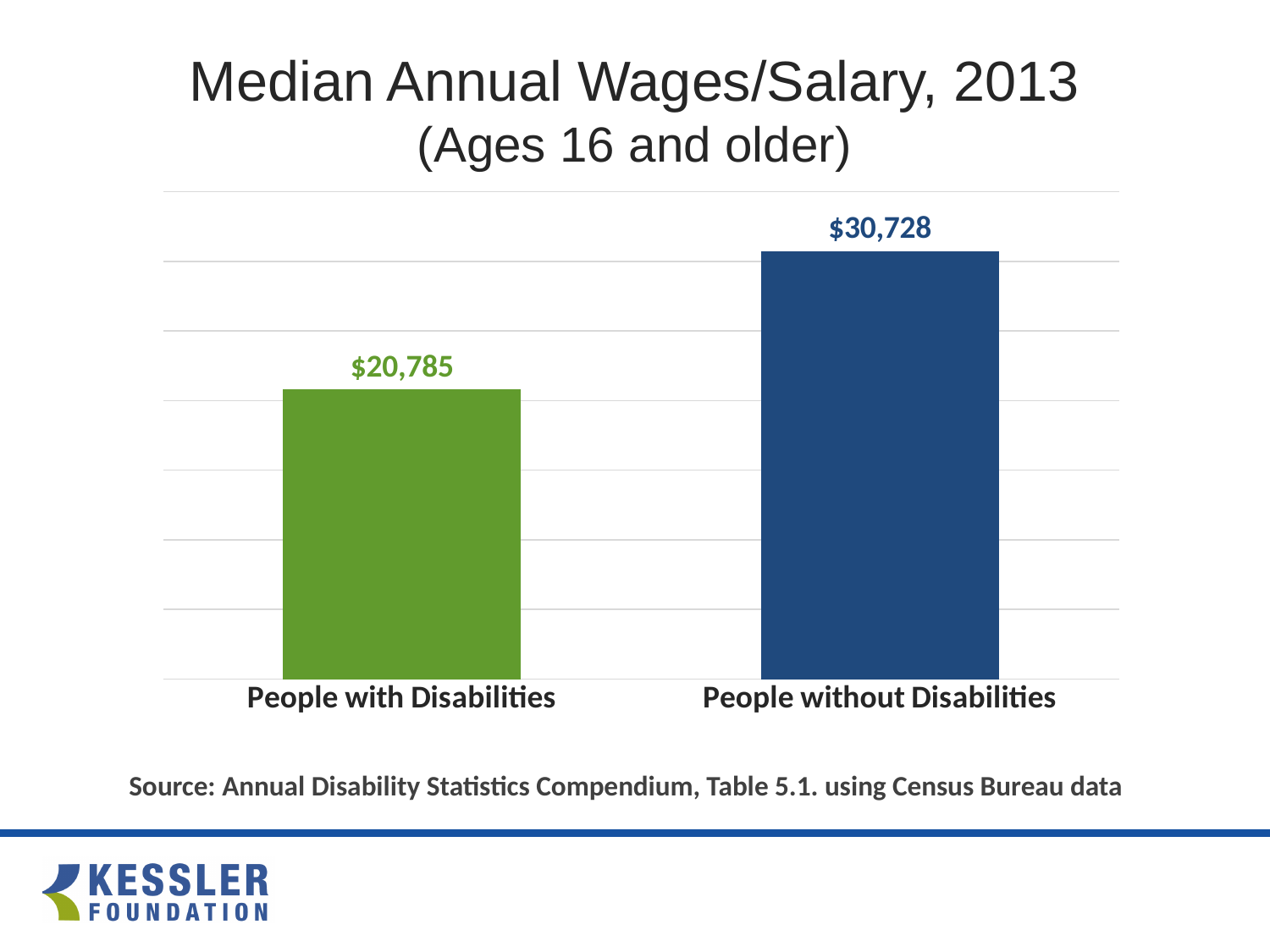
Is the median annual wage for People with Disabilities larger or smaller than that for People without Disabilities? smaller Which category has the lower median annual wage/salary? People with Disabilities What is the title of the chart? Median Annual Wages/Salary, 2013 (Ages 16 and older) Which category has the higher median annual wage/salary? People without Disabilities What kind of chart is shown on the slide? bar chart What is the median annual wage/salary for People with Disabilities? $20,785 What colour is the bar for People with Disabilities? green What is the difference between the median annual wages of People without Disabilities and People with Disabilities? $9,943 What is the median annual wage/salary for People without Disabilities? $30,728 How many categories are shown in the chart? 2